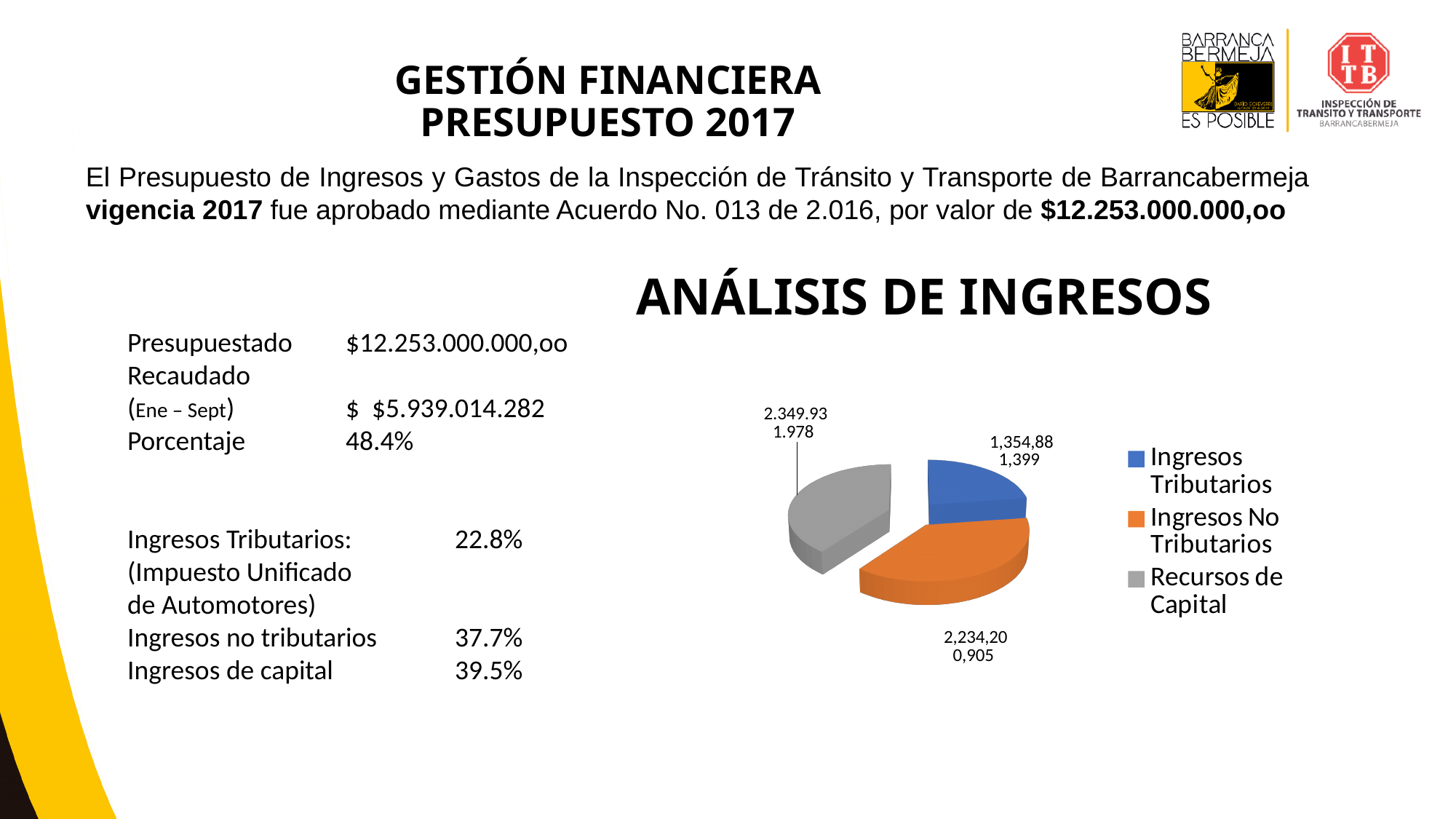
What is the value shown for Ingresos Tributarios in the pie chart? 1,354,881,399 How many entries does the legend of the pie chart list? 3 What is the difference between the values for Ingresos No Tributarios and Ingresos Tributarios in the pie chart? 879,319,506 What share of the pie does Ingresos Tributarios represent? 22.8% Which category has the smallest slice in the pie chart? Ingresos Tributarios How many slices does the pie chart have? 3 What type of chart is shown under the heading ANÁLISIS DE INGRESOS? Pie chart Which category has the largest slice in the pie chart? Recursos de Capital Which is larger in the pie chart, Ingresos No Tributarios or Ingresos Tributarios? Ingresos No Tributarios What colour is the Recursos de Capital slice in the pie chart? Gray What is the value shown for Recursos de Capital in the pie chart? 2.349.931.978 What is the value shown for Ingresos No Tributarios in the pie chart? 2,234,200,905